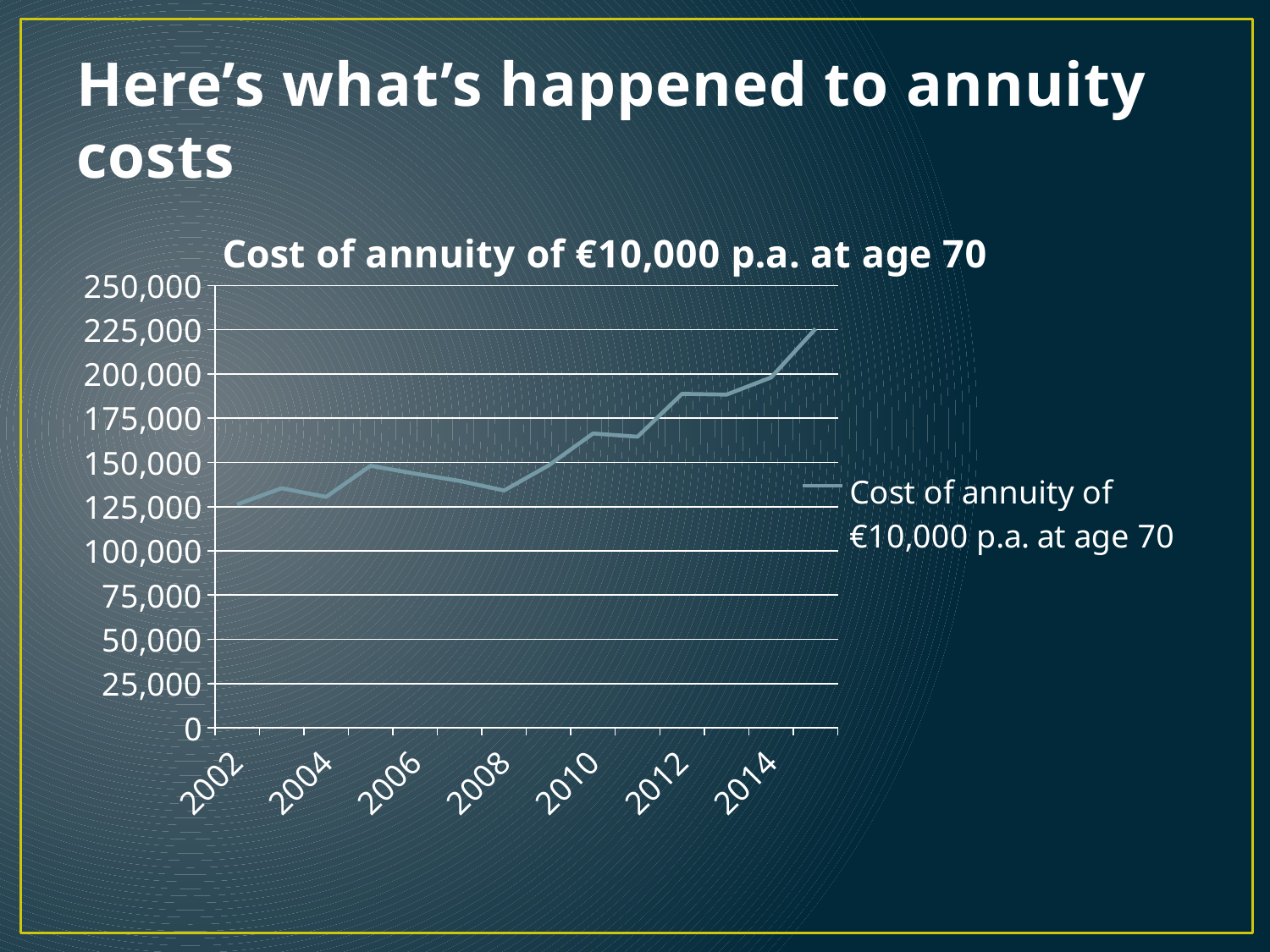
Is the value for 2006 greater or less than 150,000? less Is the value for 2002 greater or less than 150,000? less How many series does the legend list? 1 Which year has the larger value, 2008 or 2012? 2012 In which year is the cost of annuity lowest? 2002 Is the value for 2014 greater or less than 175,000? greater What kind of chart is shown on the slide? line chart In which year is the cost of annuity highest? 2015 Overall, do the values rise or fall from 2002 to the end of the series? rise What is the title of the chart? Cost of annuity of €10,000 p.a. at age 70 What is the first year shown on the x axis? 2002